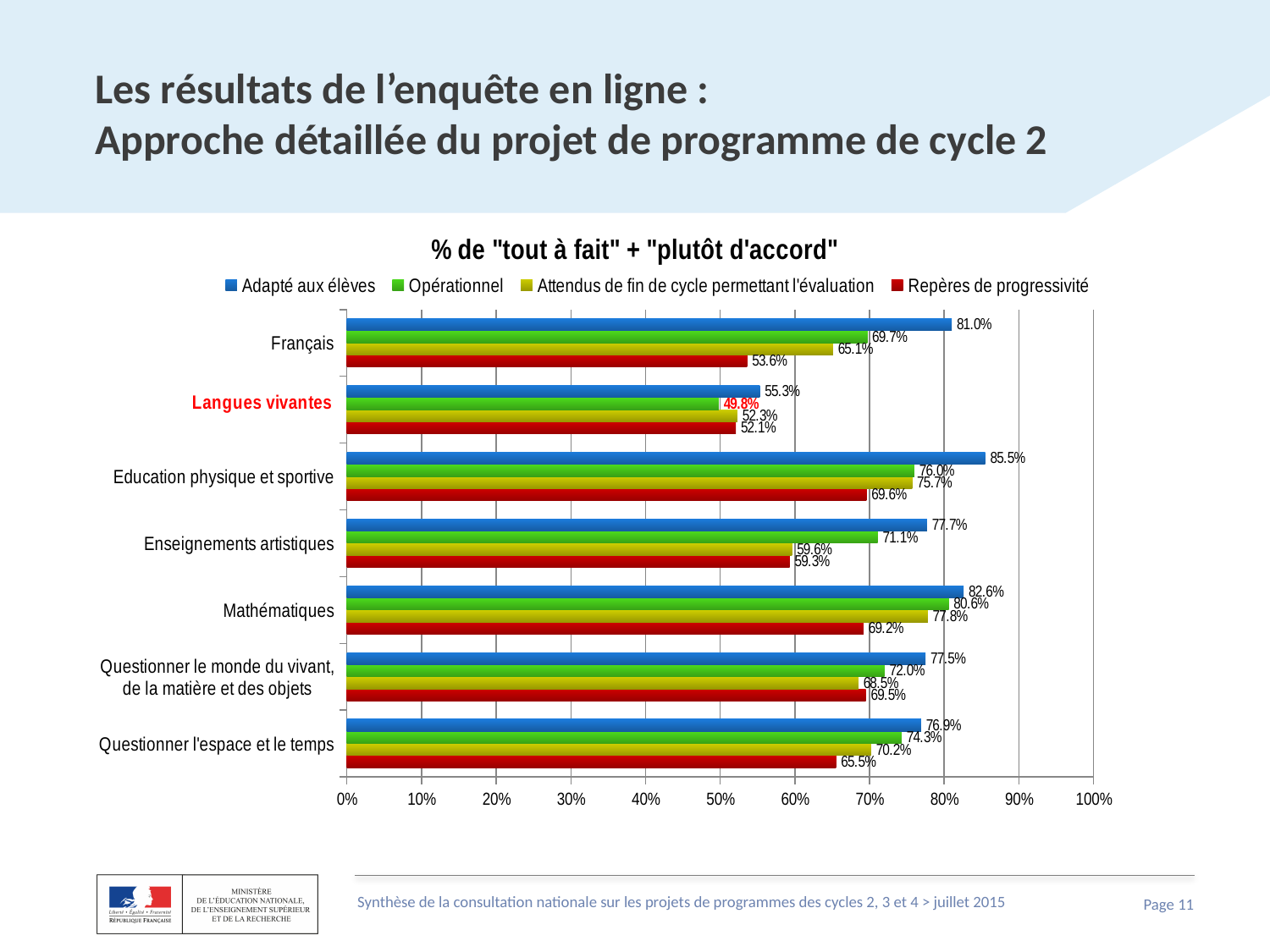
How many categories (subject areas) are shown on the chart? 7 What type of chart is shown on the slide? bar chart Which is larger for Enseignements artistiques: 'Opérationnel' or 'Attendus de fin de cycle permettant l'évaluation'? Opérationnel What is the value of 'Repères de progressivité' for Mathématiques? 69.2% What is the title of the chart? % de "tout à fait" + "plutôt d'accord" How many series does the legend list? 4 What is the difference between the 'Adapté aux élèves' value and the 'Repères de progressivité' value for Français? 27.4% Which category has the lowest value for 'Opérationnel'? Langues vivantes What is the value of 'Opérationnel' for Langues vivantes? 49.8% Is the 'Adapté aux élèves' value for Langues vivantes greater or less than 60%? less Which category has the highest value for 'Adapté aux élèves'? Education physique et sportive What is the value of 'Adapté aux élèves' for Français? 81.0%